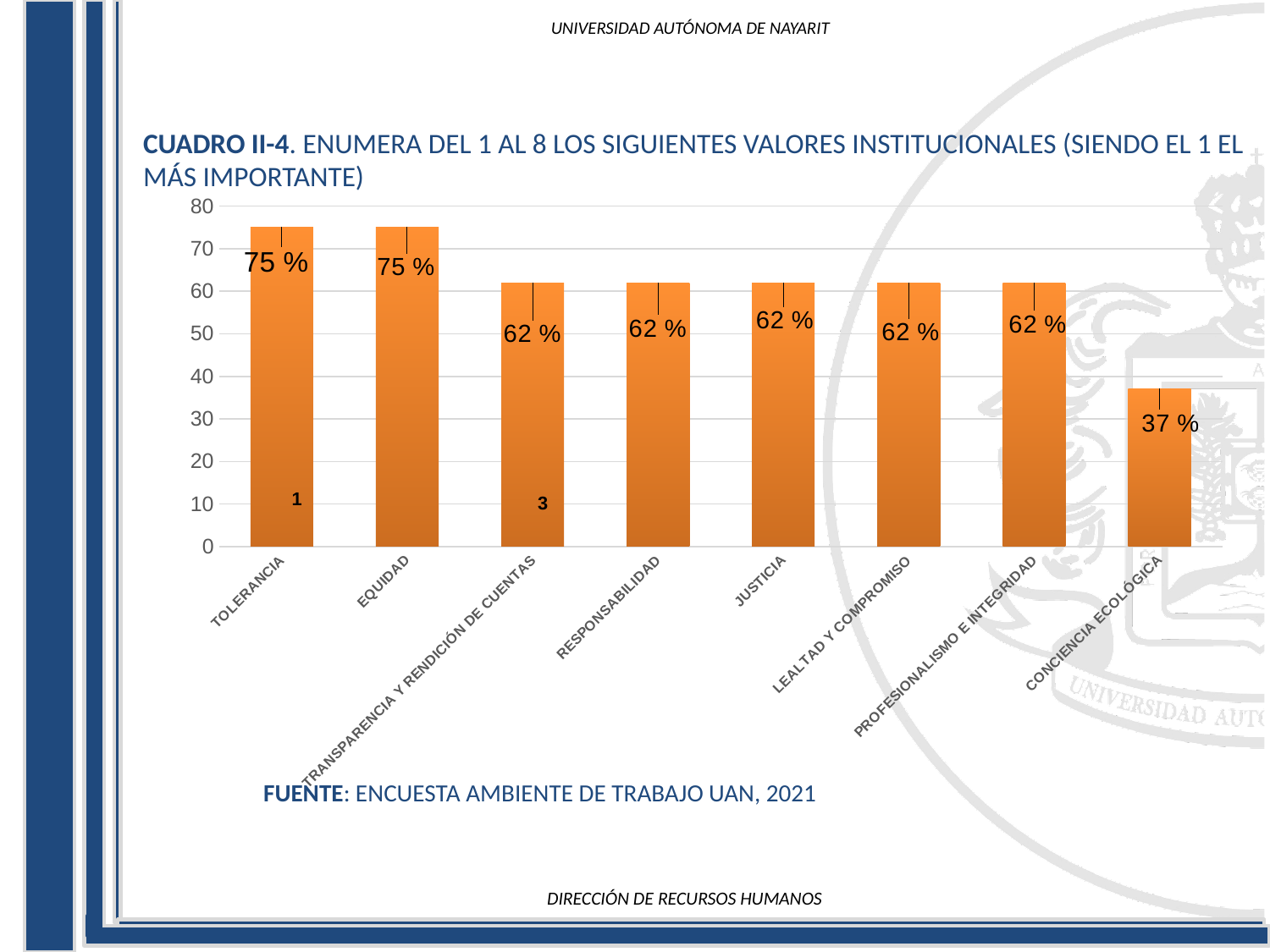
Do the values rise or fall from left to right along the x axis? fall What is the value for TOLERANCIA? 75 % Which is larger, the value for TOLERANCIA or the value for RESPONSABILIDAD? TOLERANCIA What kind of chart is shown on the slide? bar chart What is the value for EQUIDAD? 75 % What is the value for JUSTICIA? 62 % How many categories are shown on the x axis? 8 Is the value for CONCIENCIA ECOLÓGICA greater or less than 40? less What is the value for CONCIENCIA ECOLÓGICA? 37 % What is the difference between the value for EQUIDAD and the value for LEALTAD Y COMPROMISO? 13 % What source is cited below the chart? ENCUESTA AMBIENTE DE TRABAJO UAN, 2021 Which category has the lowest value? CONCIENCIA ECOLÓGICA